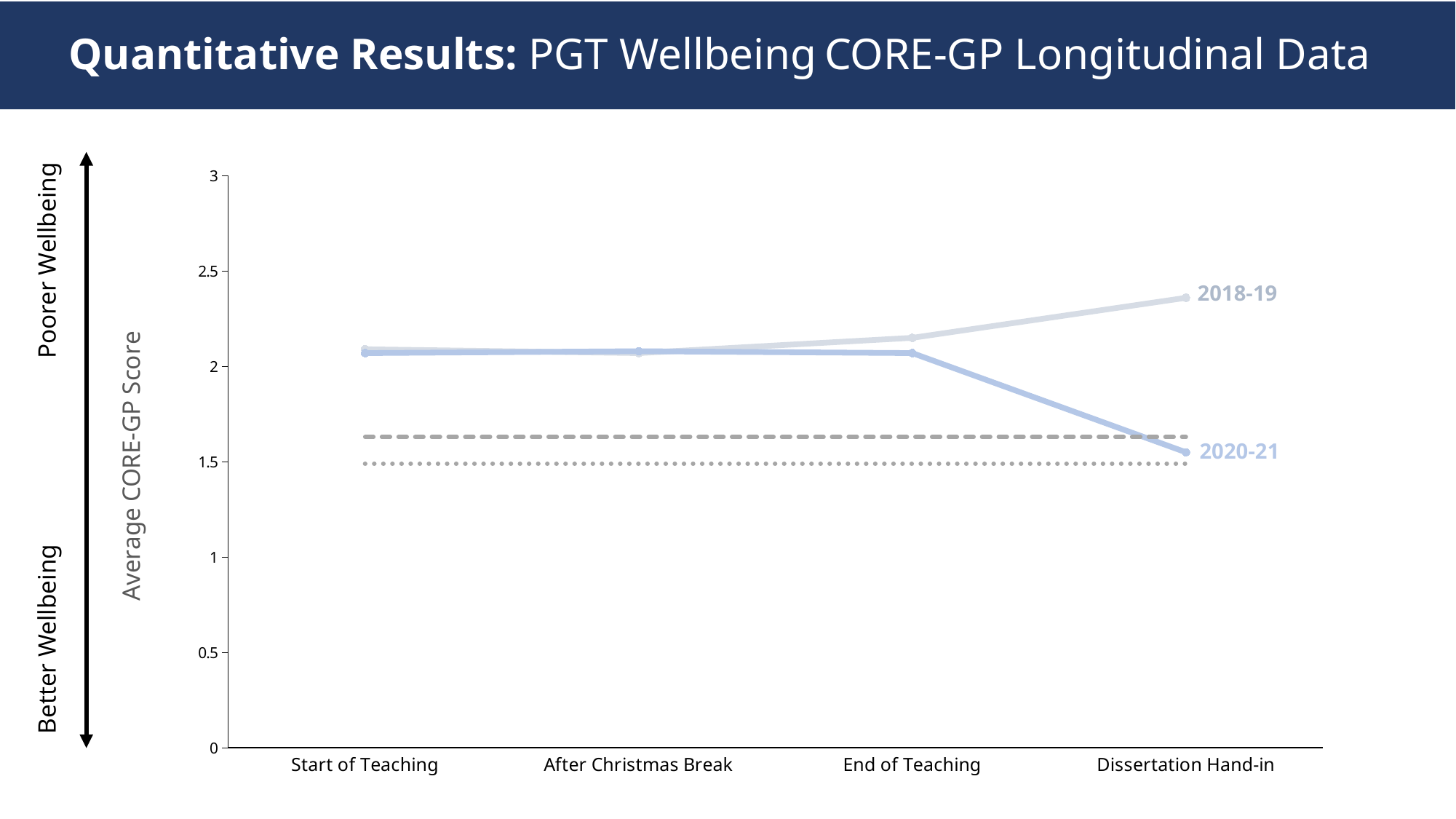
How many time points are plotted along the x axis? 4 At which time point does the 2020-21 series reach its lowest value? Dissertation Hand-in Is the value for 2018-19 at Dissertation Hand-in greater or less than 2? greater Which cohort has the higher value at Dissertation Hand-in, 2018-19 or 2020-21? 2018-19 Does the 2020-21 series rise or fall between End of Teaching and Dissertation Hand-in? fall Is the value for 2020-21 at Start of Teaching greater or less than 2? greater Is the value for 2018-19 at Dissertation Hand-in greater or less than 2.5? less At which time point does the 2018-19 series reach its highest value? Dissertation Hand-in How many labelled data series (cohorts) are plotted on the chart? 2 What kind of chart is shown on the slide? line chart What is the title of the vertical axis? Average CORE-GP Score